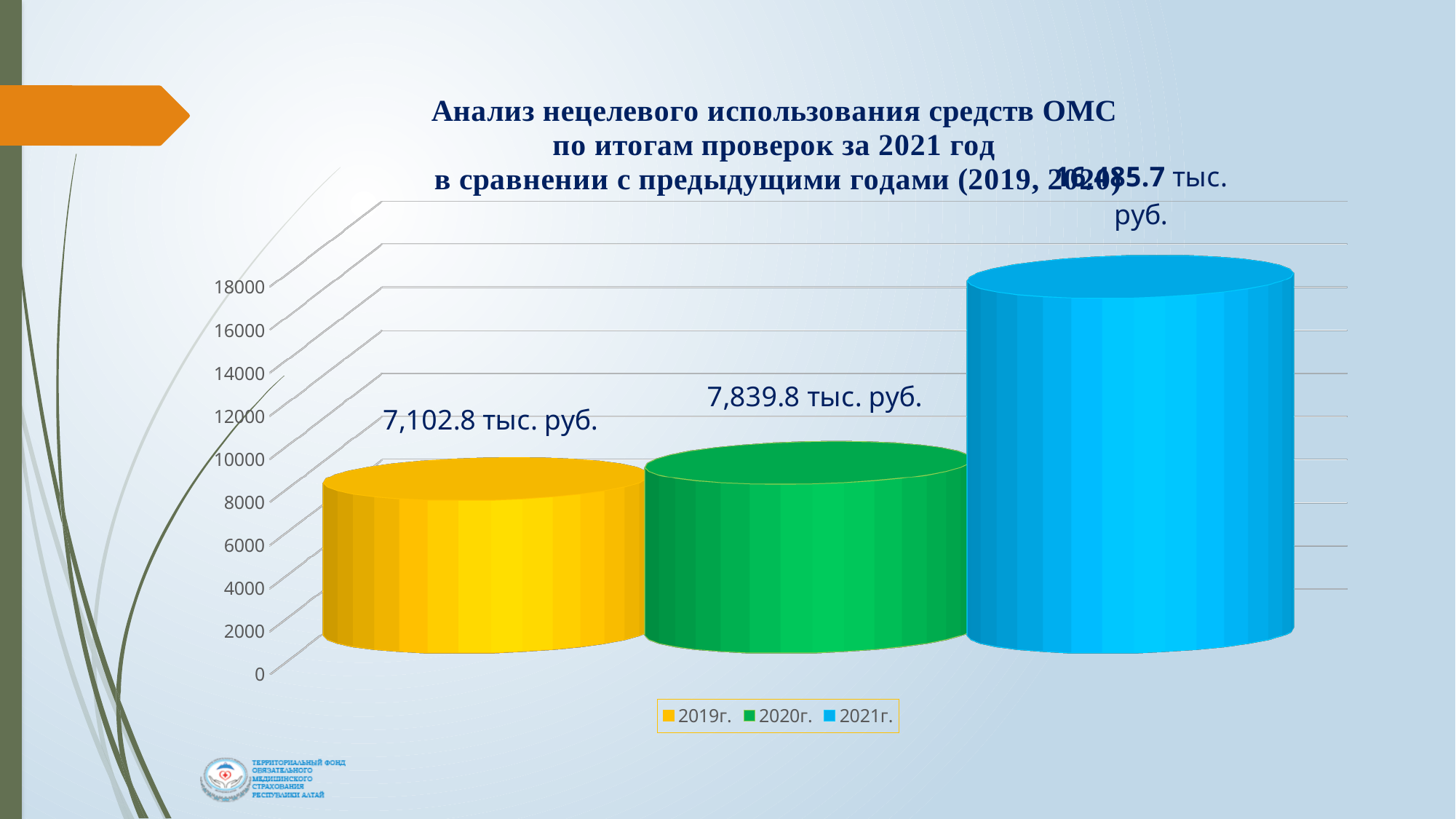
What kind of chart is shown on the slide? bar chart What is the value shown for 2020г.? 7,839.8 тыс. руб. What is the value shown for 2019г.? 7,102.8 тыс. руб. Which is larger, the value for 2019г. or the value for 2020г.? 2020г. Do the values rise or fall from 2019г. to 2021г.? rise How many entries does the legend list? 3 How many bars are plotted on the chart? 3 Which year has the lowest value on the chart? 2019г. What is the difference between the values for 2020г. and 2019г.? 737.0 тыс. руб. Is the value for 2021г. greater or less than 14000? greater Is the value for 2019г. greater or less than 8000? less Which year has the highest value on the chart? 2021г.